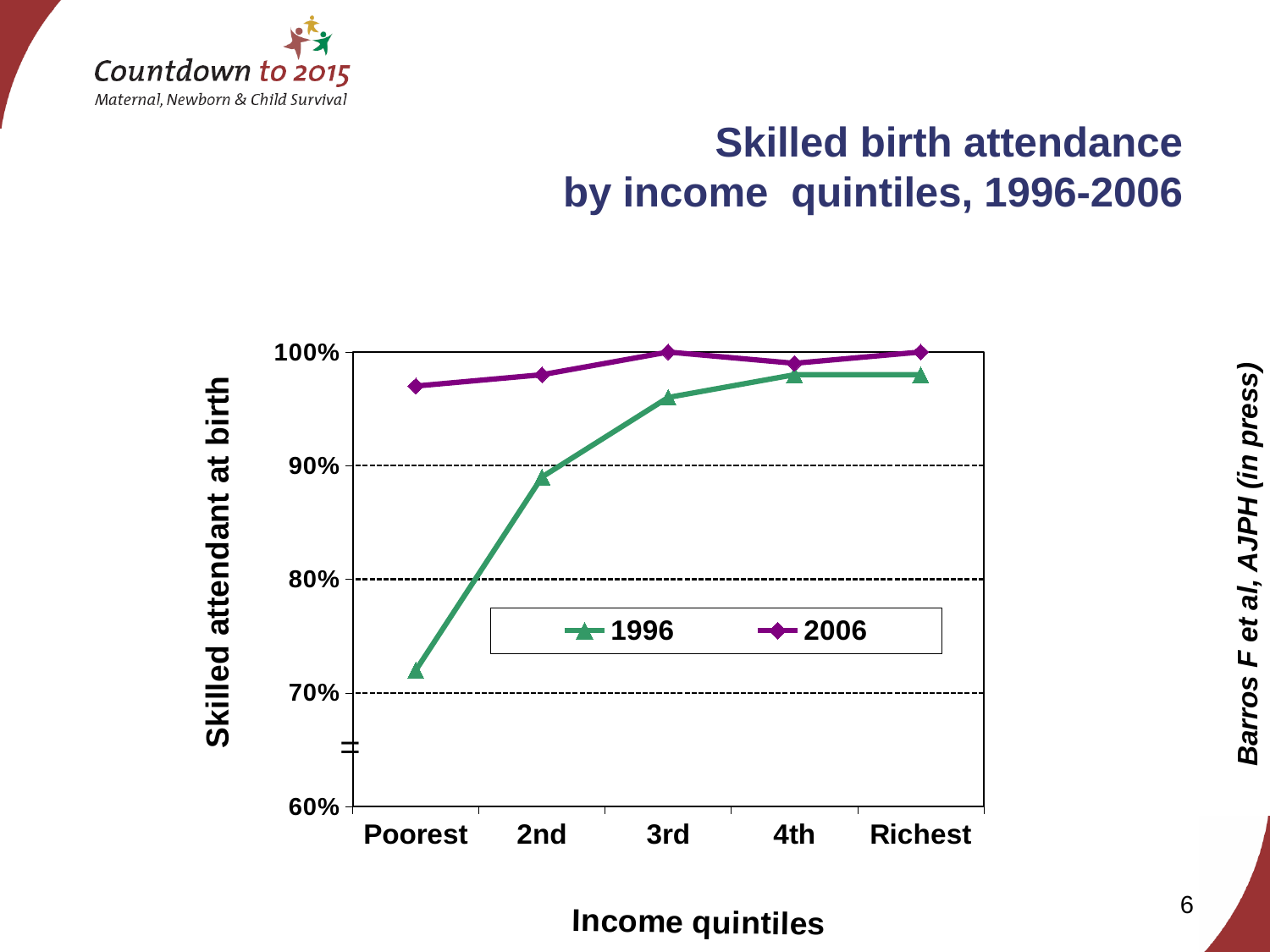
Is the 2006 value for the Poorest quintile greater or less than 90%? greater Is the 1996 value for the Poorest quintile greater or less than 80%? less Is the 1996 value for the 2nd quintile greater or less than 80%? greater What is the title of the y axis? Skilled attendant at birth For the Poorest quintile, which series has the larger value, 1996 or 2006? 2006 How many series does the legend list? 2 Which income quintile has the lowest value for the 1996 series? Poorest Which income quintile has the lowest value for the 2006 series? Poorest How many income quintile categories are shown on the x axis? 5 What kind of chart is shown on the slide? line chart Does the 1996 series rise or fall from the Poorest to the Richest quintile? rise